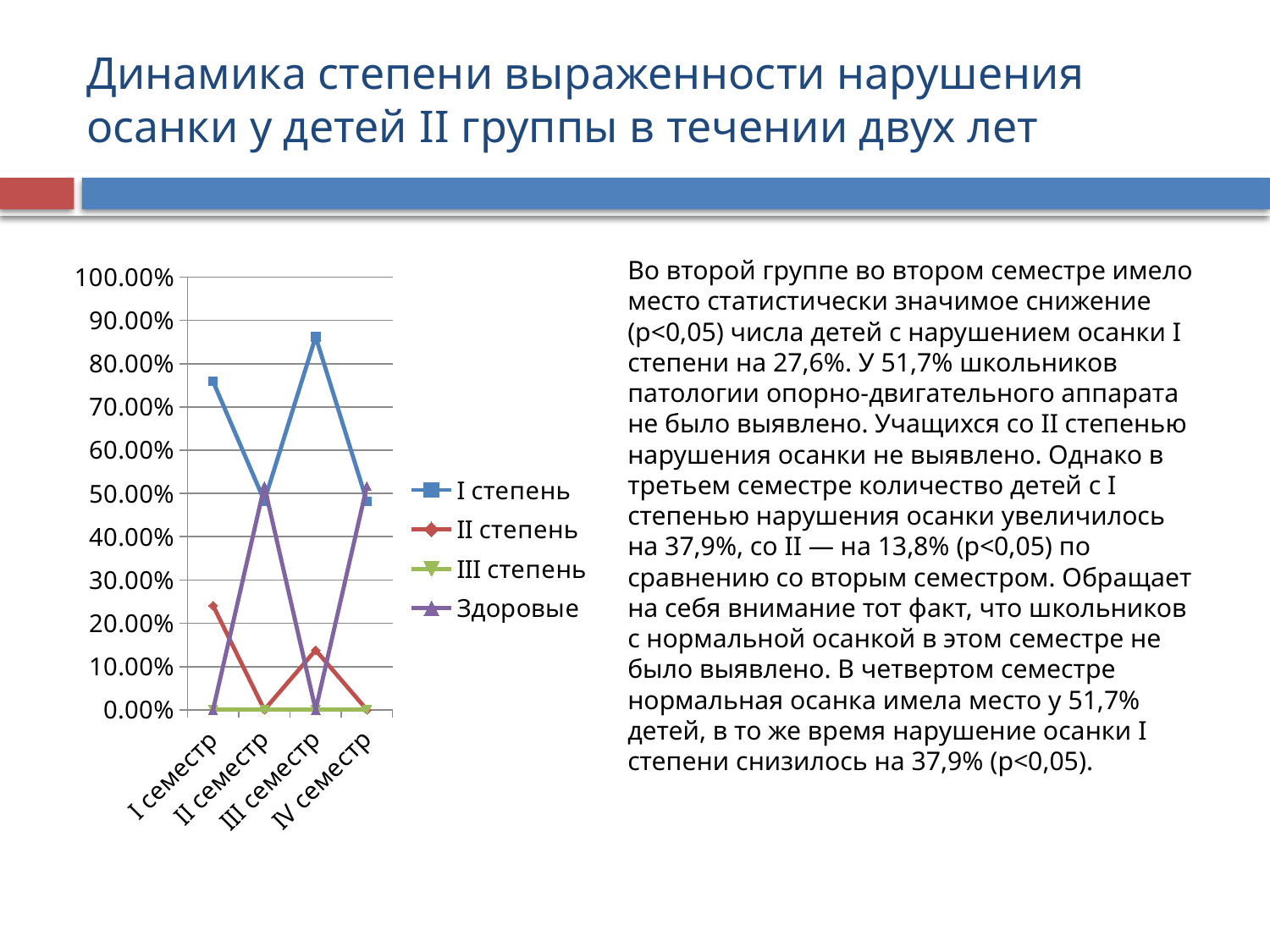
What kind of chart is shown on the slide? line chart Is the value for II степень in I семестр greater or less than 30.00%? less Does the II степень series rise or fall from I семестр to II семестр? fall Is the value for I степень in I семестр greater or less than 70.00%? greater Which series is shown with the green line in the chart? III степень Is the value for Здоровые in II семестр greater or less than 40.00%? greater How many semesters (categories) are shown on the x axis of the chart? 4 How many series does the chart legend list? 4 In which semester does the II степень series reach its highest value? I семестр In I семестр, which series has the larger value: I степень or Здоровые? I степень In which semester does the I степень series reach its highest value? III семестр